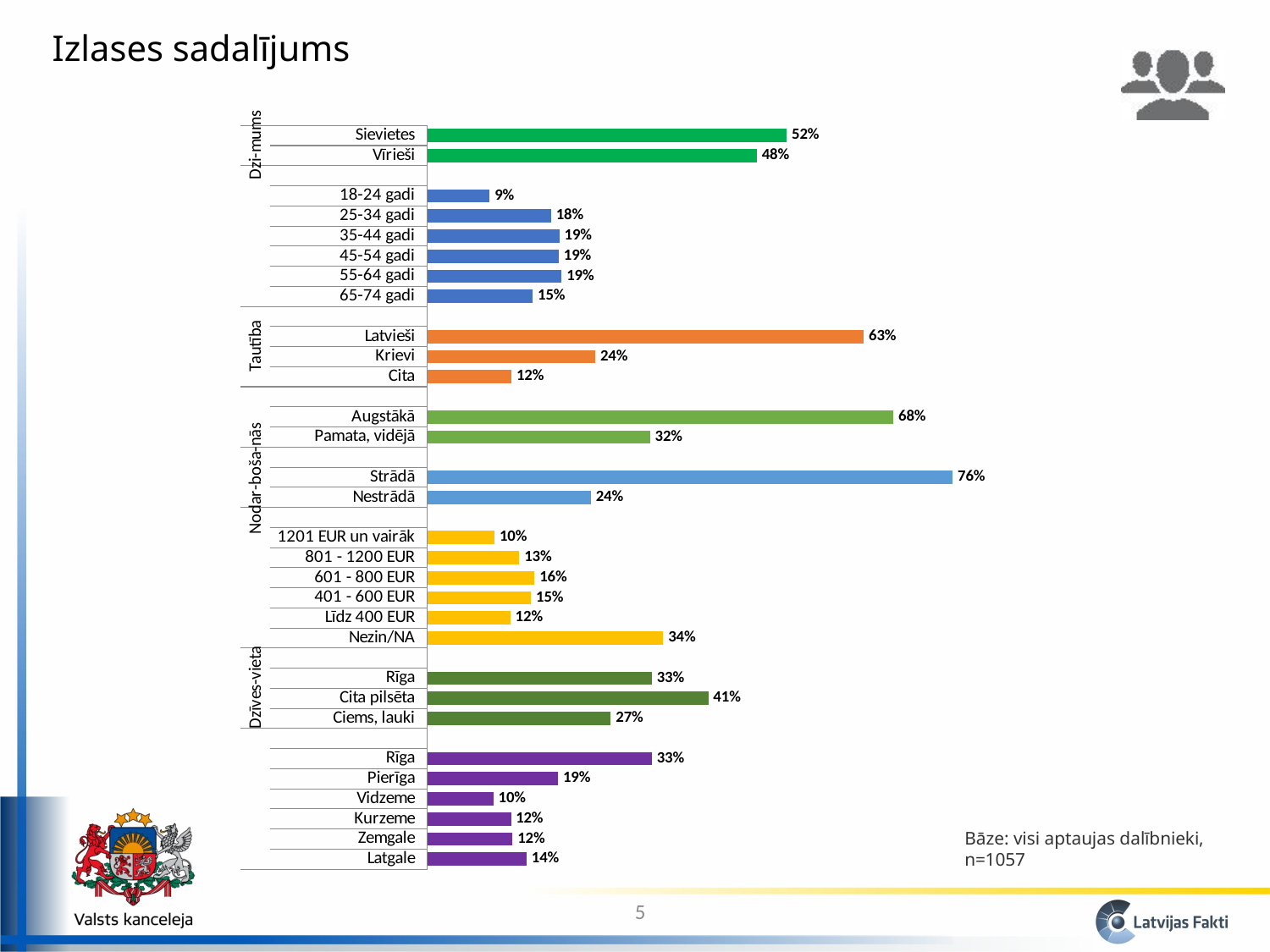
What is the value for Strādā? 76% What is the difference between Latvieši and Krievi? 39% What is the title of the slide's chart? Izlases sadalījums What kind of chart is shown on the slide? bar chart What is the value for Sievietes? 52% Which is larger, Cita pilsēta or Ciems, lauki? Cita pilsēta What is the value for Nezin/NA? 34% Which age group (gadi) has the lowest value? 18-24 gadi What is the value for Latvieši? 63% Which category has the highest value in the whole chart? Strādā What is the difference between Augstākā and Pamata, vidējā? 36% How many bars are plotted in the chart in total? 30